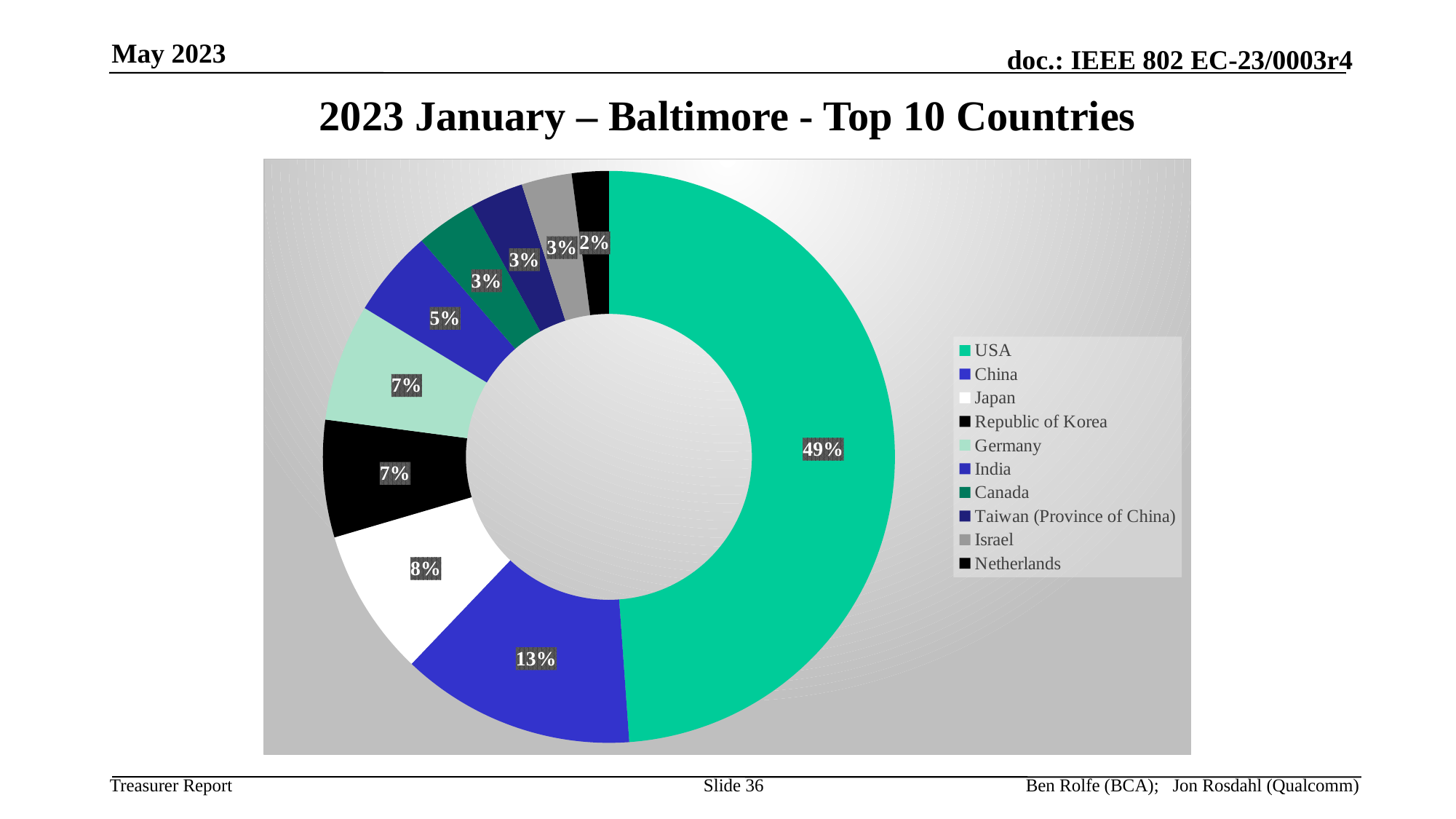
What share of the chart does USA account for? 49% Which has the larger share, Japan or India? Japan What is the title of the slide? 2023 January – Baltimore - Top 10 Countries What kind of chart is shown on the slide? Doughnut (pie) chart What percentage is shown for China? 13% Which country has the smallest share of the chart? Netherlands How many percentage points larger is the USA share than the China share? 36 percentage points What percentage is shown for Japan? 8% What percentage is shown for Netherlands? 2% Which country has the largest share of the chart? USA What percentage is shown for India? 5% How many countries are listed in the legend? 10